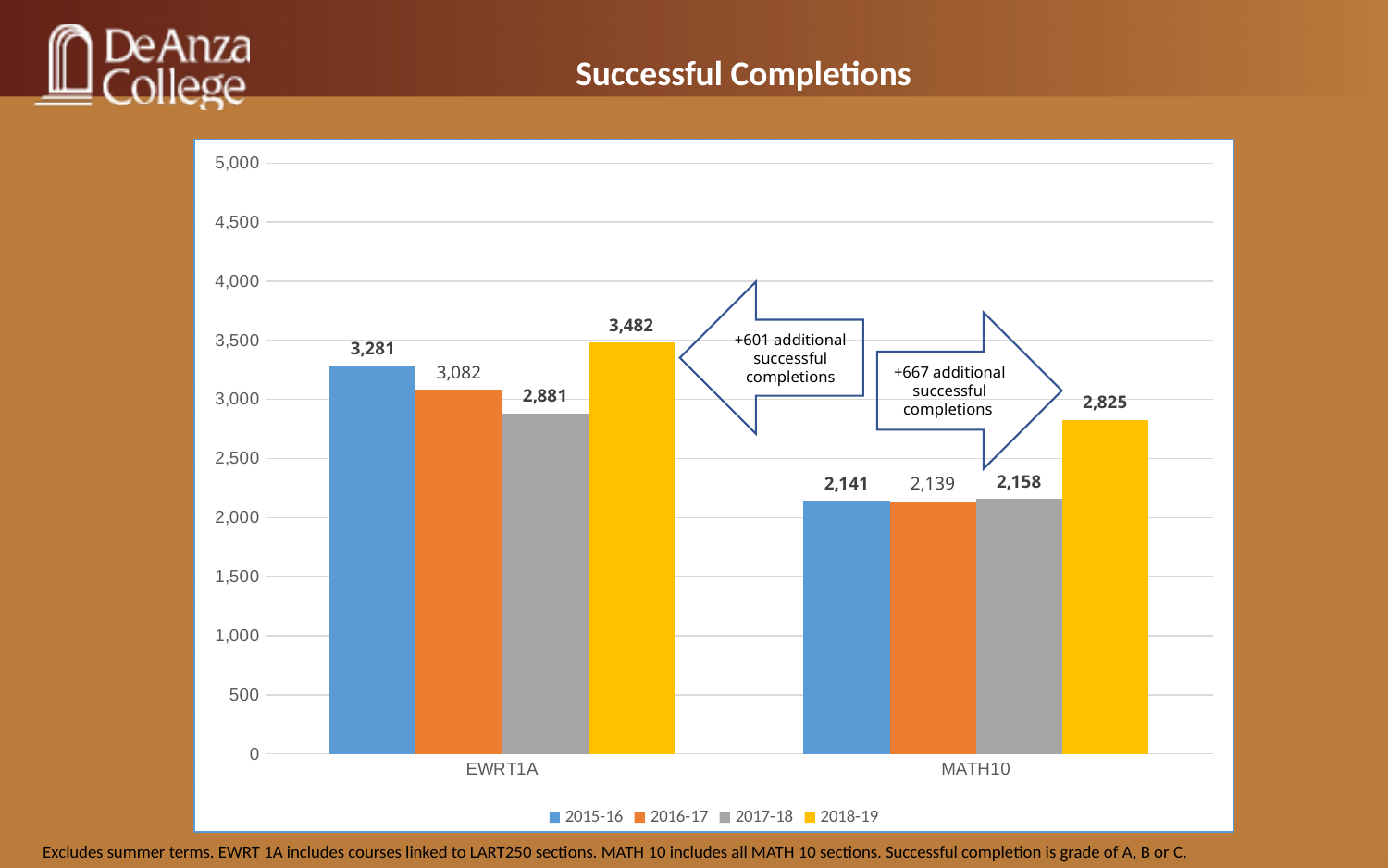
Is the value for MATH10 in 2018-19 greater or less than 2,500? greater What is the difference between the 2018-19 and 2017-18 values for MATH10? 667 How many categories are shown on the x axis? 2 How many series does the legend list? 4 Which year has the highest value for MATH10? 2018-19 Which is larger, the 2015-16 value for EWRT1A or the 2016-17 value for EWRT1A? 2015-16 value for EWRT1A What kind of chart is shown on the slide? bar chart What is the value for EWRT1A in 2018-19? 3,482 What is the difference between the 2018-19 and 2017-18 values for EWRT1A? 601 Which year has the lowest value for EWRT1A? 2017-18 What is the value for MATH10 in 2016-17? 2,139 What is the value for EWRT1A in 2017-18? 2,881